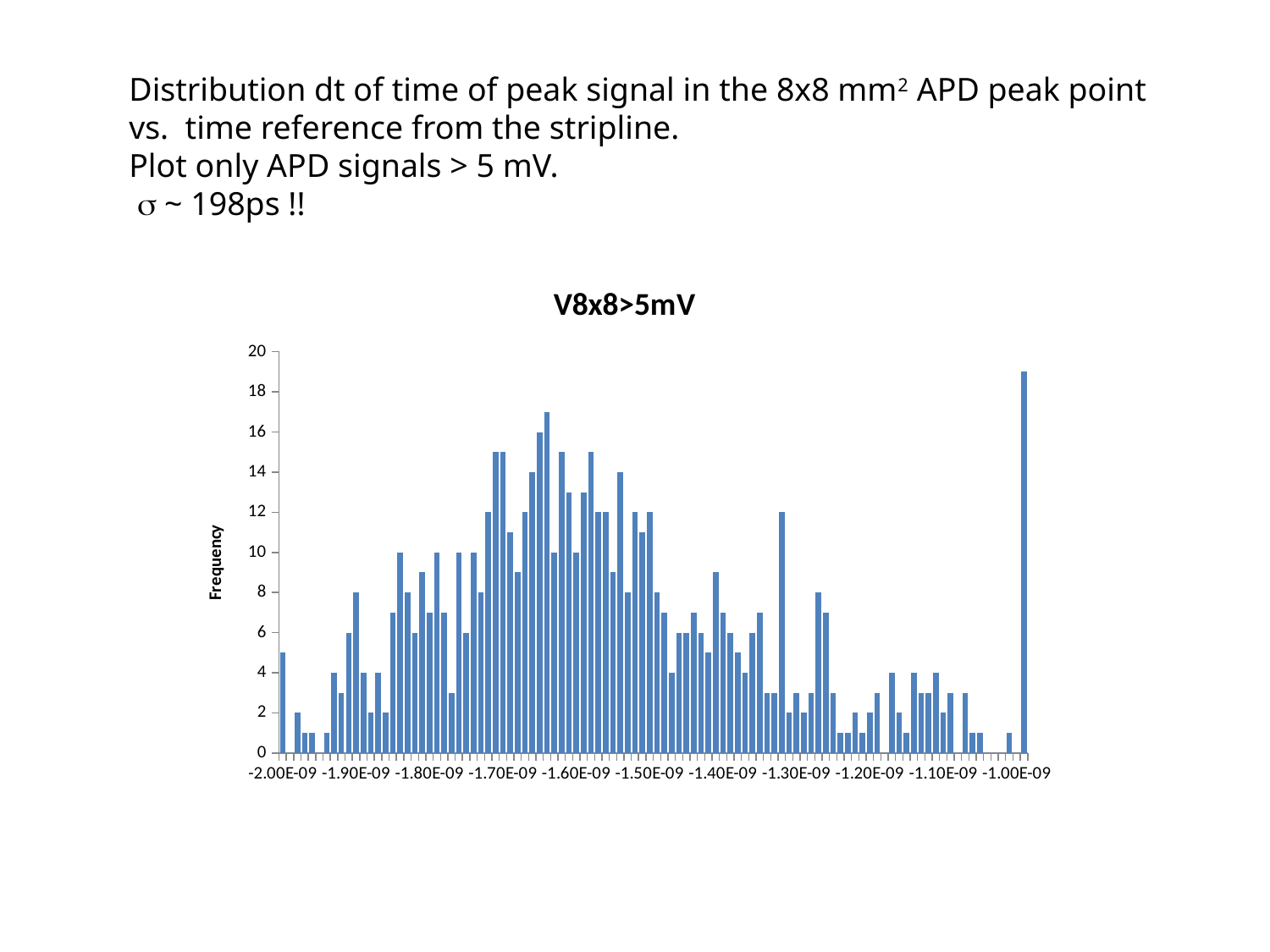
Is the value of the tallest bar (near -1.00E-09) greater or less than 20? less Which is taller: the tallest bar near -1.00E-09 or the tallest bar near -1.60E-09? the bar near -1.00E-09 Is the value of the tallest bar (near -1.00E-09) greater or less than 18? greater Is the value of the first bar at -2.00E-09 greater or less than 4? greater Near which x-axis tick label does the tallest bar of the histogram appear? -1.00E-09 What is the label on the vertical axis of the chart? Frequency What kind of chart is shown on the slide? bar chart What is the title of the chart? V8x8>5mV What is the highest tick value shown on the vertical axis? 20